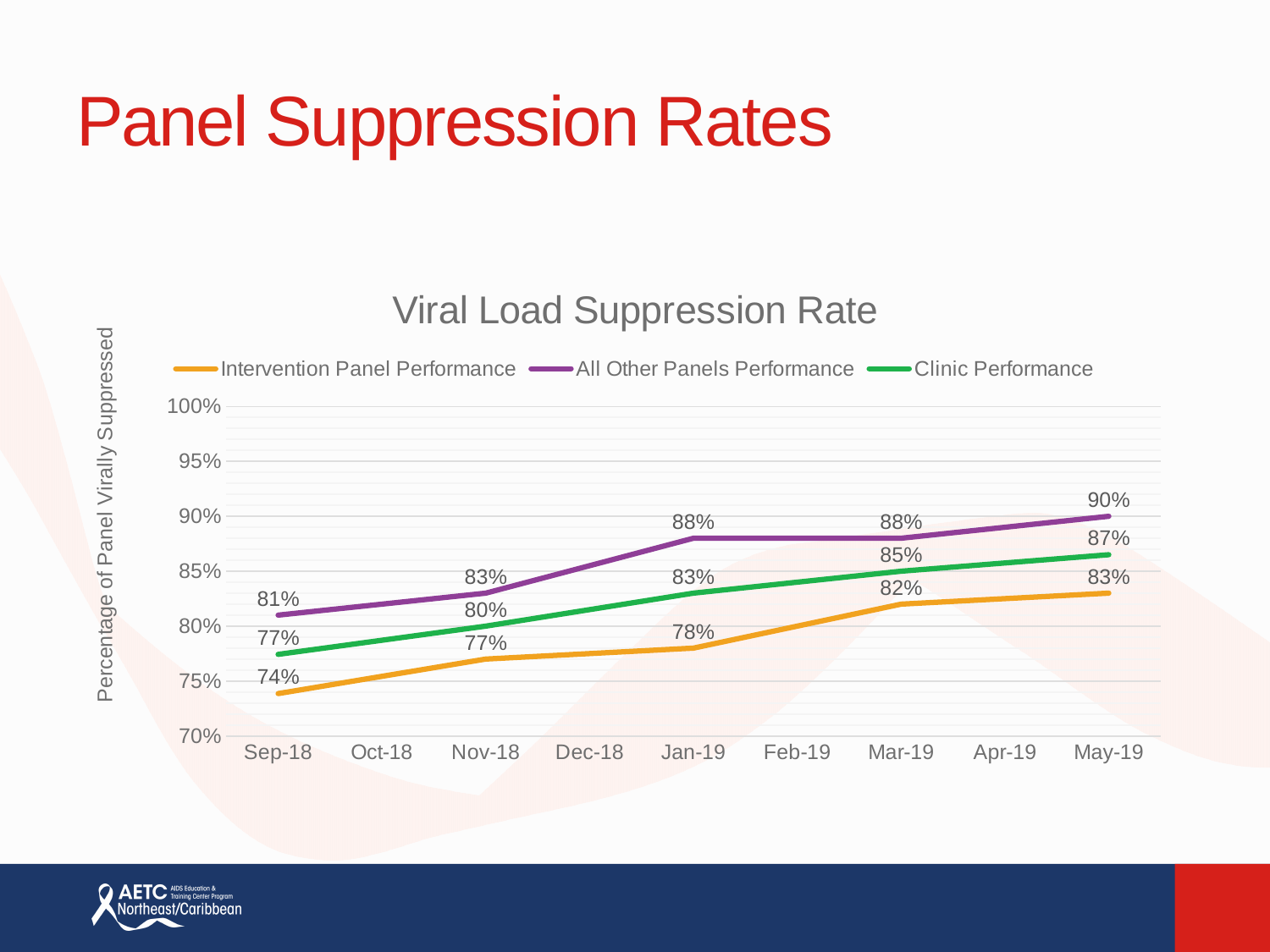
What kind of chart is shown on the slide? Line chart By how much did Intervention Panel Performance increase from Sep-18 to May-19? 9% What is the Clinic Performance value in Mar-19? 85% What is the All Other Panels Performance value in Jan-19? 88% How many months are labelled on the x axis of the chart? 9 Does the Intervention Panel Performance line rise or fall from Sep-18 to May-19? Rise What is the Intervention Panel Performance value in Sep-18? 74% What is the difference between All Other Panels Performance and Intervention Panel Performance in Sep-18? 7% Which series has the lowest value in Nov-18? Intervention Panel Performance How many series does the legend list in the Viral Load Suppression Rate chart? 3 Which series has the highest value in May-19? All Other Panels Performance What is the All Other Panels Performance value in May-19? 90%